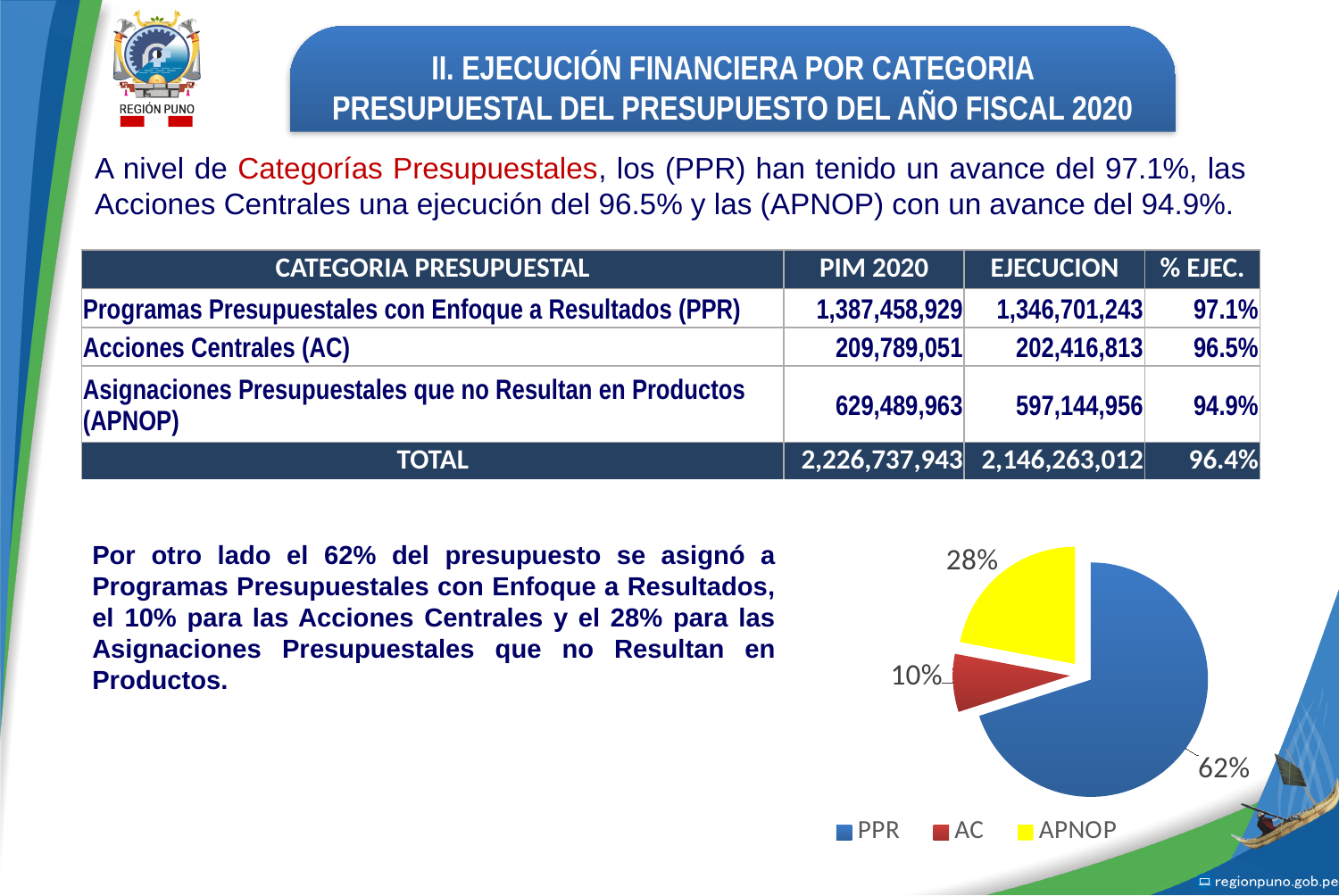
What type of chart is shown on the slide? pie chart What is the difference in percentage points between the APNOP slice and the AC slice? 18 What is the difference in percentage points between the PPR slice and the APNOP slice? 34 Which category has the smallest slice of the pie? AC Which slice is larger, AC or APNOP? APNOP What colour is the APNOP slice in the pie chart? yellow What share of the pie does AC represent? 10% How many slices does the pie chart have? 3 What share of the pie does PPR represent? 62% Which category has the largest slice of the pie? PPR What share of the pie does APNOP represent? 28% How many entries does the legend of the pie chart list? 3